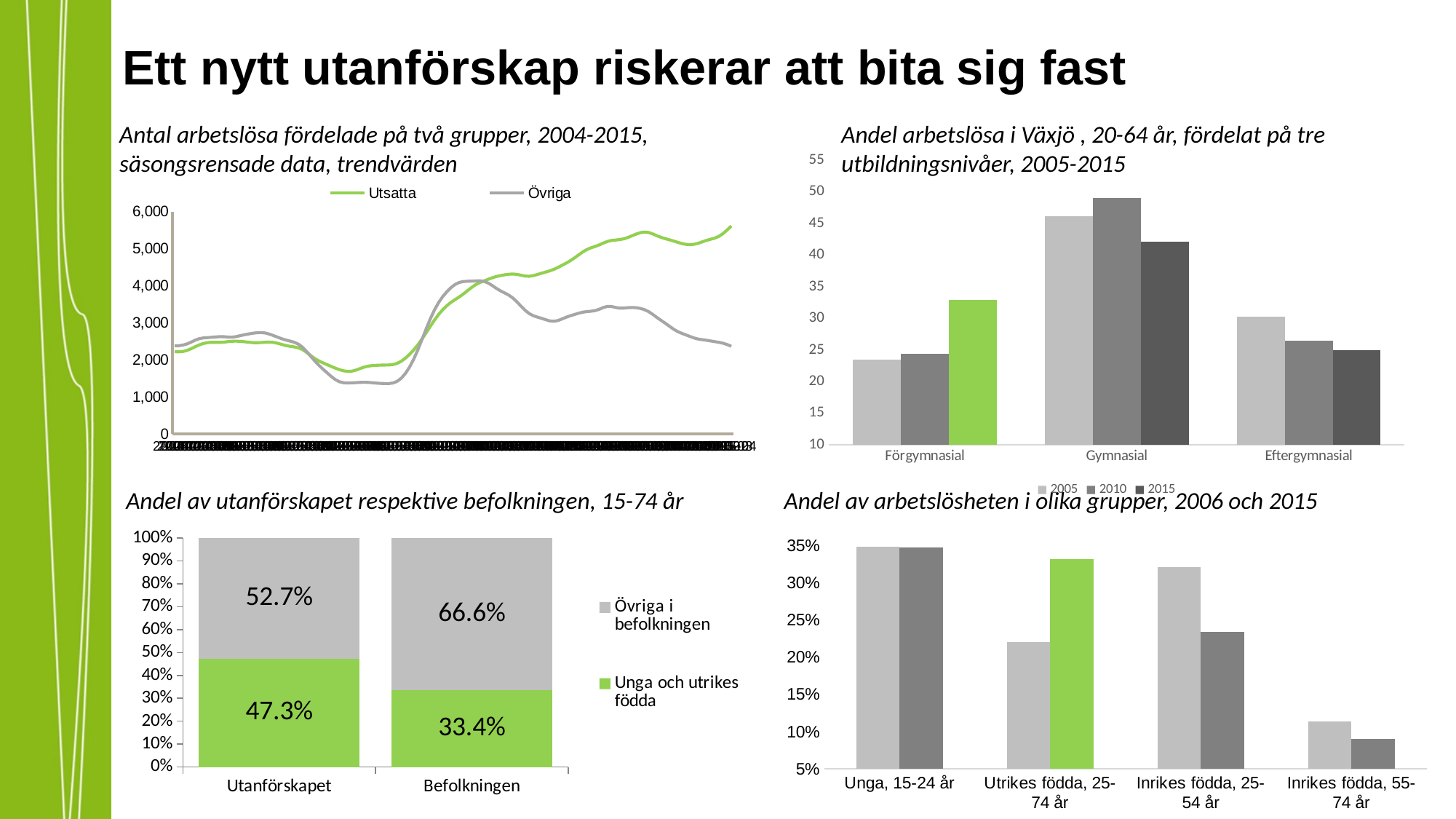
In the chart 'Andel av utanförskapet respektive befolkningen, 15-74 år', which bar has the larger Unga och utrikes födda share, Utanförskapet or Befolkningen? Utanförskapet In the chart 'Andel av utanförskapet respektive befolkningen, 15-74 år', what is the value for Övriga i befolkningen in the Befolkningen bar? 66.6% What kind of chart is 'Antal arbetslösa fördelade på två grupper, 2004-2015, säsongsrensade data, trendvärden'? line chart How many series does the legend list in the chart 'Andel av utanförskapet respektive befolkningen, 15-74 år'? 2 In the chart 'Andel arbetslösa i Växjö, 20-64 år, fördelat på tre utbildningsnivåer, 2005-2015', is the 2015 value for Förgymnasial greater or less than 30? greater In the chart 'Andel av arbetslösheten i olika grupper, 2006 och 2015', how many groups are shown on the x axis? 4 In the chart 'Antal arbetslösa fördelade på två grupper, 2004-2015', which series is higher at the right end of the x axis, Utsatta or Övriga? Utsatta In the chart 'Andel av arbetslösheten i olika grupper, 2006 och 2015', which group has the lowest values? Inrikes födda, 55-74 år In the chart 'Andel av utanförskapet respektive befolkningen, 15-74 år', what is the value for Unga och utrikes födda in the Utanförskapet bar? 47.3% In the chart 'Andel arbetslösa i Växjö, 20-64 år, fördelat på tre utbildningsnivåer, 2005-2015', how many education-level categories are shown on the x axis? 3 In the chart 'Andel arbetslösa i Växjö, 20-64 år, fördelat på tre utbildningsnivåer, 2005-2015', which year has the highest value for Gymnasial? 2010 In the chart 'Andel av utanförskapet respektive befolkningen, 15-74 år', what is the difference between the Övriga i befolkningen and Unga och utrikes födda values in the Utanförskapet bar? 5.4 percentage points